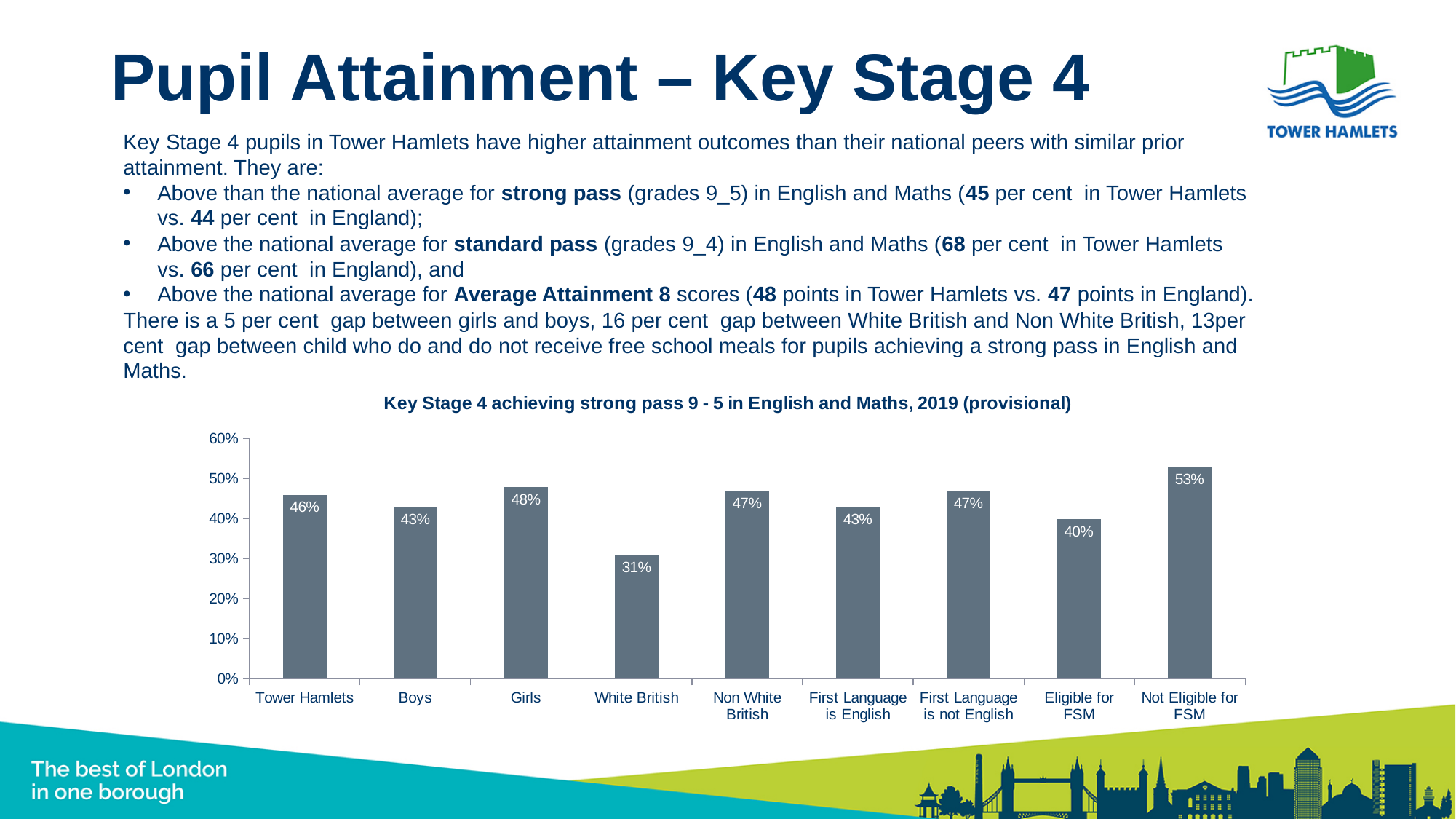
What is the difference between Non White British and White British? 16% Which category has the highest value in the chart? Not Eligible for FSM What kind of chart is shown on the slide? Bar chart Is the value for First Language is not English greater or less than 40%? greater How many categories are shown on the x axis of the chart? 9 Which category has the lowest value in the chart? White British Which is larger, the value for Eligible for FSM or Not Eligible for FSM? Not Eligible for FSM What percentage of White British pupils achieved a strong pass 9 - 5 in English and Maths? 31% What is the difference between the values for Girls and Boys? 5% What is the value for Tower Hamlets in the chart? 46% What is the value for pupils Not Eligible for FSM? 53% What is the title of the chart? Key Stage 4 achieving strong pass 9 - 5 in English and Maths, 2019 (provisional)